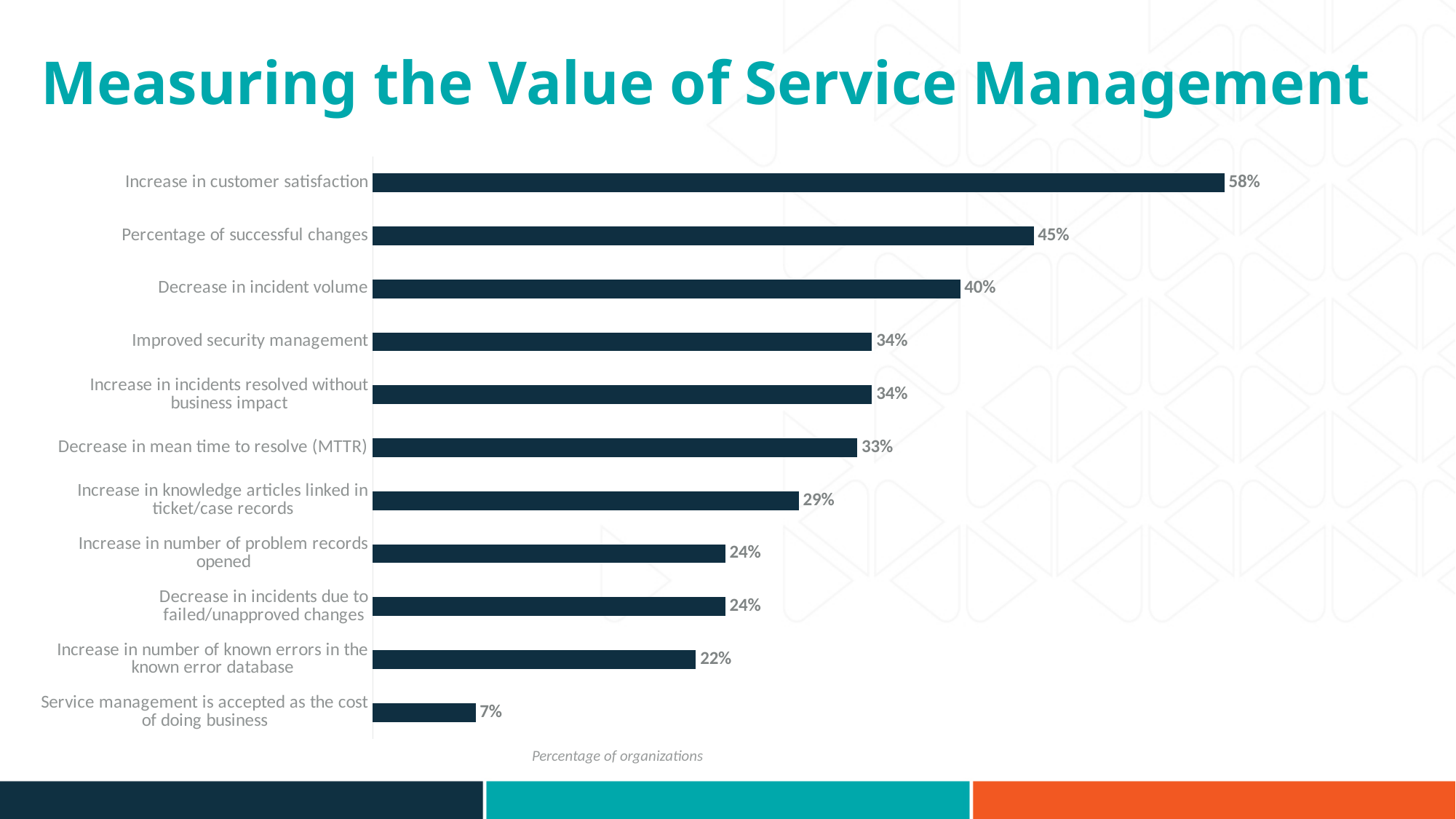
What is the value for 'Decrease in mean time to resolve (MTTR)'? 33% What percentage of organizations reported an increase in customer satisfaction? 58% What is the value for 'Decrease in incident volume'? 40% What is the difference between 'Increase in knowledge articles linked in ticket/case records' and 'Increase in number of problem records opened'? 5% What is the value for 'Increase in number of known errors in the known error database'? 22% How many categories are shown in the chart? 11 Which category has the lowest value? Service management is accepted as the cost of doing business What kind of chart is shown on the slide? Bar chart Which is larger: 'Improved security management' or 'Decrease in mean time to resolve (MTTR)'? Improved security management What is the difference between 'Increase in customer satisfaction' and 'Percentage of successful changes'? 13% Which category has the highest value? Increase in customer satisfaction What is the label on the horizontal axis of the chart? Percentage of organizations